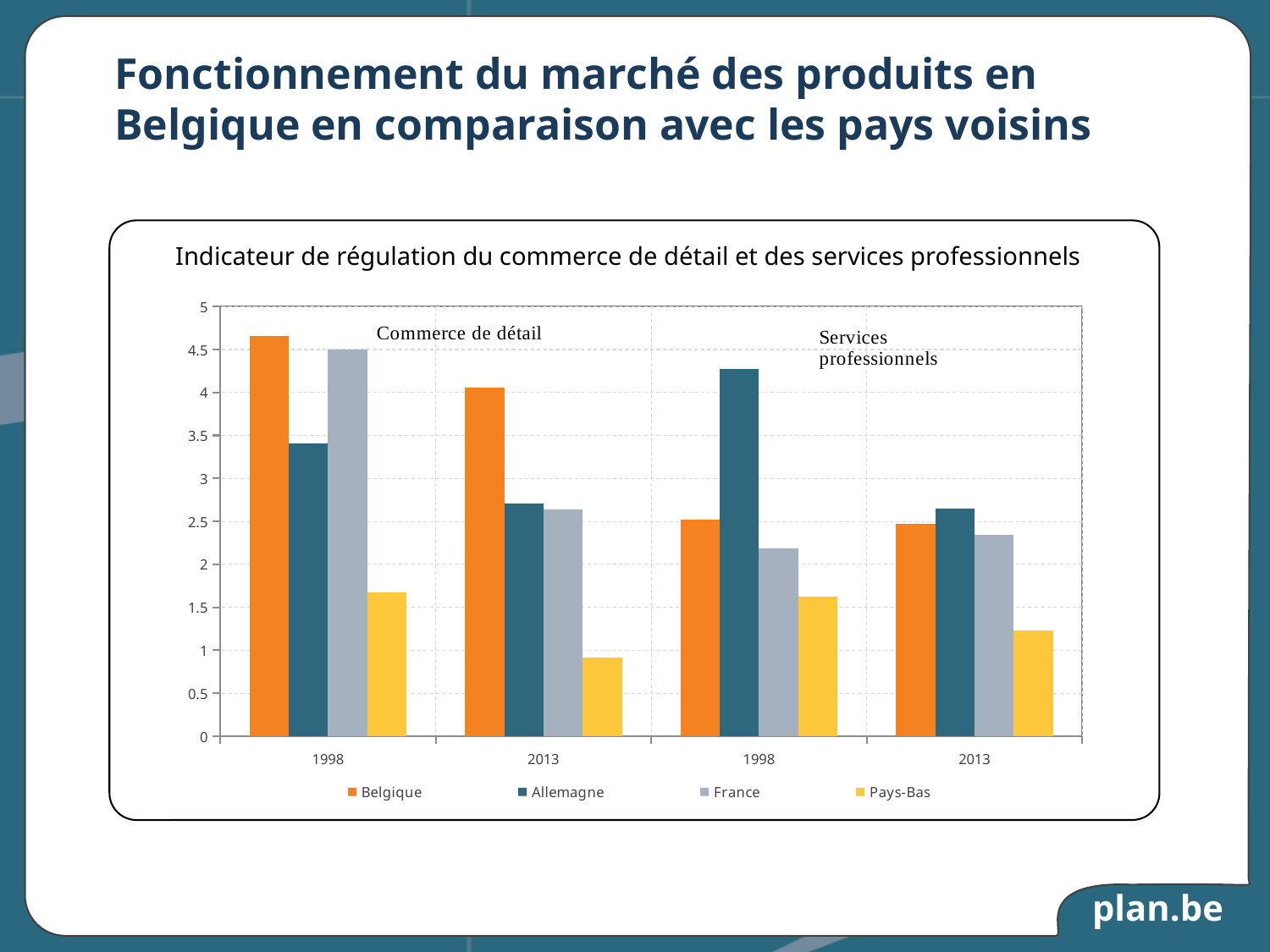
Is the value for Allemagne in Services professionnels 1998 greater or less than 4? greater How many year groups are shown along the x axis? 4 Does the value for Pays-Bas in Commerce de détail rise or fall from 1998 to 2013? fall How many series does the legend list? 4 Is the value for Pays-Bas in Commerce de détail 2013 greater or less than 1.5? less Is the value for Belgique in Commerce de détail 2013 greater or less than 3.5? greater What kind of chart is shown on the slide? Bar chart In the Commerce de détail 1998 group, which is larger: Belgique or Allemagne? Belgique In the Services professionnels 1998 group, which country has the highest value? Allemagne In the Commerce de détail 1998 group, which country has the highest value? Belgique In the Commerce de détail 1998 group, which country has the lowest value? Pays-Bas In the Services professionnels 2013 group, which country has the lowest value? Pays-Bas